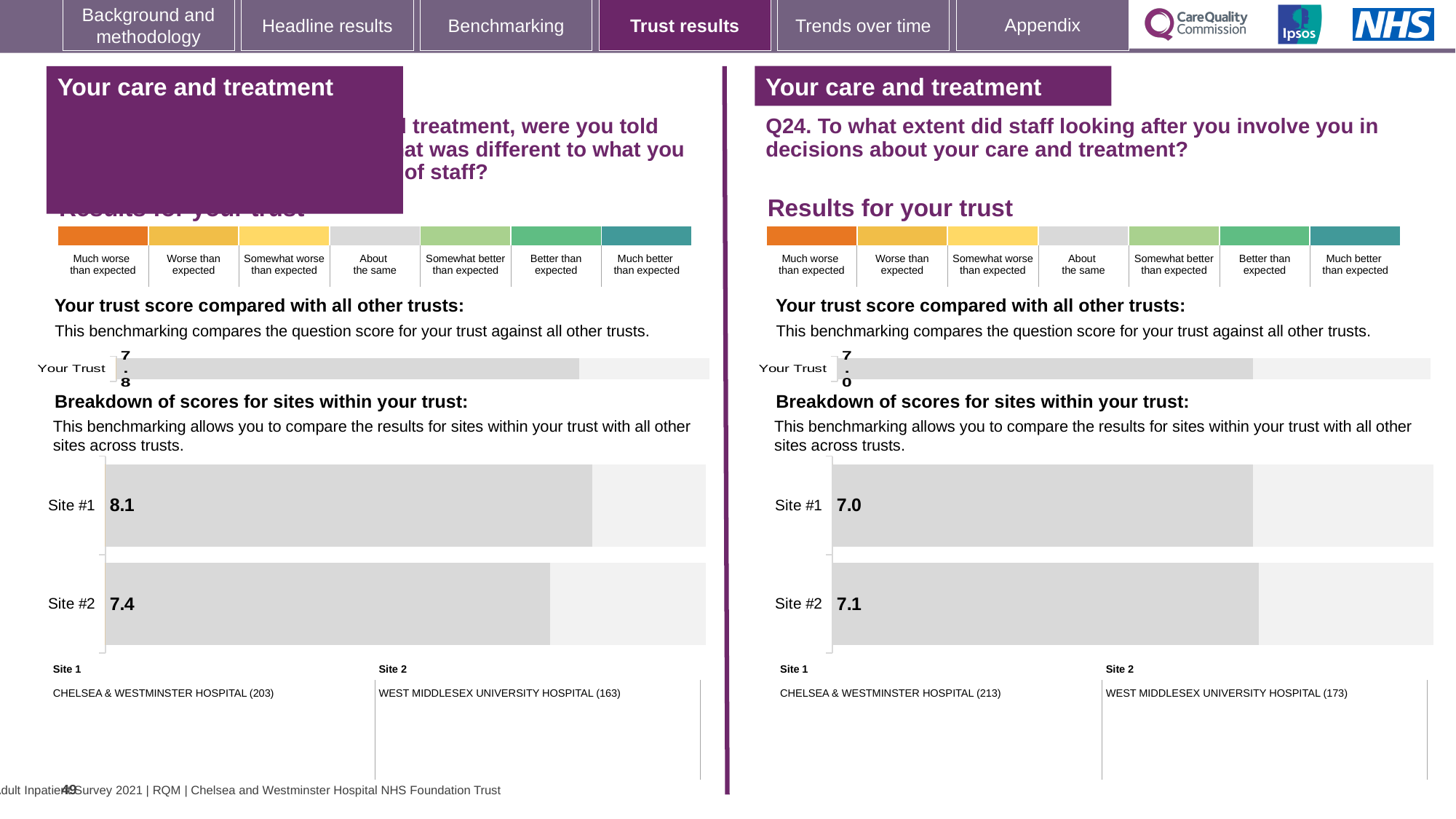
On the left panel's site breakdown chart, what is the score for Site #2? 7.4 On the left panel's site breakdown chart, what is the score for Site #1? 8.1 How many sites are shown on the left panel's site breakdown chart? 2 On the left panel's 'Your trust score compared with all other trusts' chart, what is the score for Your Trust? 7.8 On the right panel (Q24) site breakdown chart, what is the score for Site #2? 7.1 What type of chart is the site breakdown chart on the right panel (Q24)? Bar chart On the right panel (Q24) site breakdown chart, what is the difference between the Site #2 and Site #1 scores? 0.1 On the right panel (Q24) 'Your trust score compared with all other trusts' chart, what is the score for Your Trust? 7.0 On the right panel (Q24), which hospital is listed as Site 1? CHELSEA & WESTMINSTER HOSPITAL (213) On the right panel (Q24) site breakdown chart, what is the score for Site #1? 7.0 On the left panel's site breakdown chart, which site has the higher score? Site #1 On the left panel's site breakdown chart, what is the difference between the Site #1 and Site #2 scores? 0.7